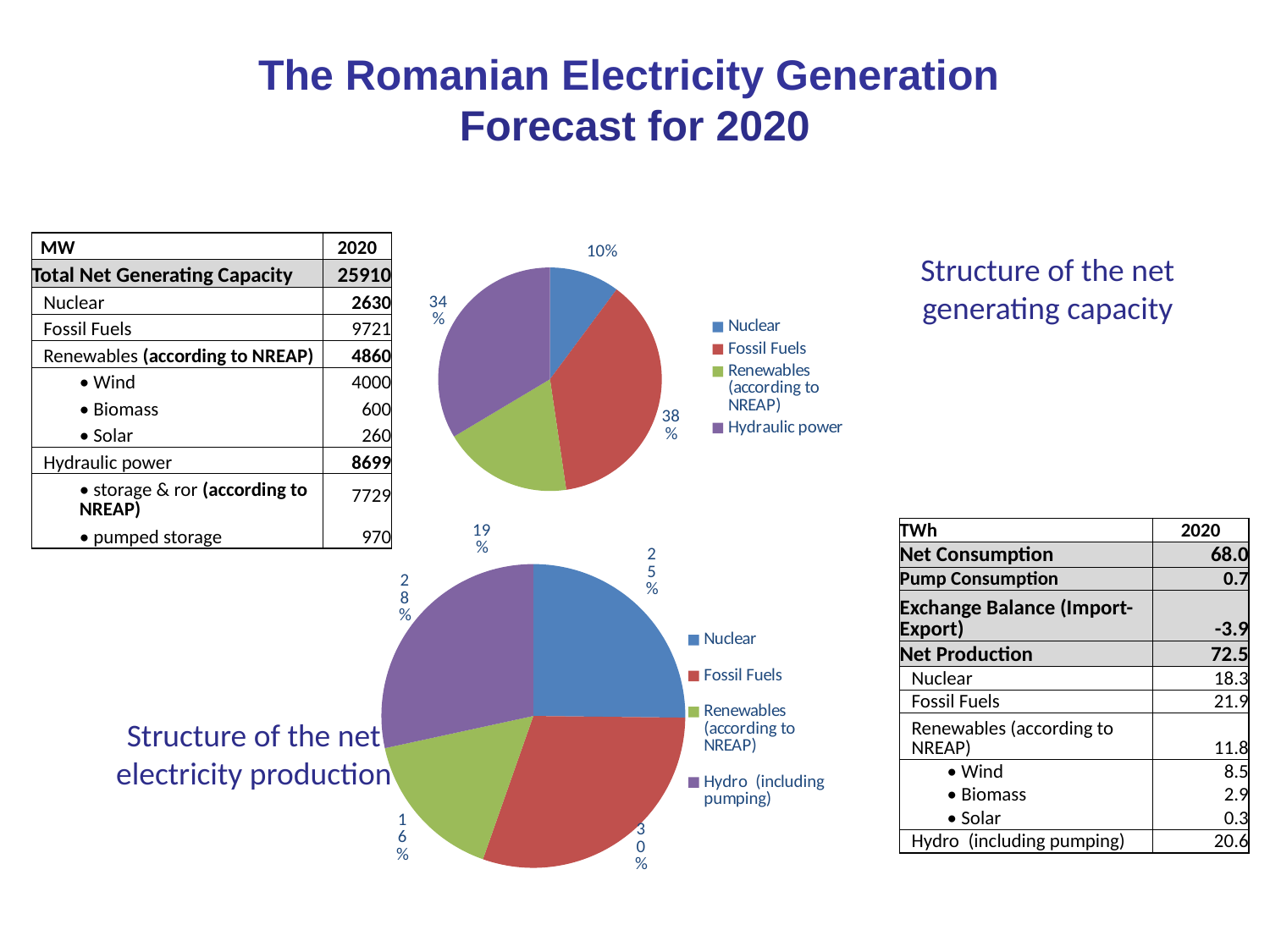
In the 'Structure of the net electricity production' pie chart, which is larger, the Nuclear share or the Hydro (including pumping) share? Hydro (including pumping) In the 'Structure of the net generating capacity' pie chart, what share is shown for Nuclear? 10% How many categories does the legend of the 'Structure of the net electricity production' pie chart list? 4 In the 'Structure of the net electricity production' pie chart, what share is shown for Hydro (including pumping)? 28% What type of chart is used to show the structure of the net generating capacity? Pie chart In the 'Structure of the net generating capacity' pie chart, which category has the smallest slice? Nuclear In the 'Structure of the net generating capacity' pie chart, what share is shown for Hydraulic power? 34% In the 'Structure of the net electricity production' pie chart, what share is shown for Renewables (according to NREAP)? 16% In the 'Structure of the net generating capacity' pie chart, what share is shown for Fossil Fuels? 38% In the 'Structure of the net generating capacity' pie chart, which category has the largest slice? Fossil Fuels In the 'Structure of the net electricity production' pie chart, what share is shown for Fossil Fuels? 30% In the 'Structure of the net generating capacity' pie chart, what is the difference between the Fossil Fuels share and the Hydraulic power share? 4%